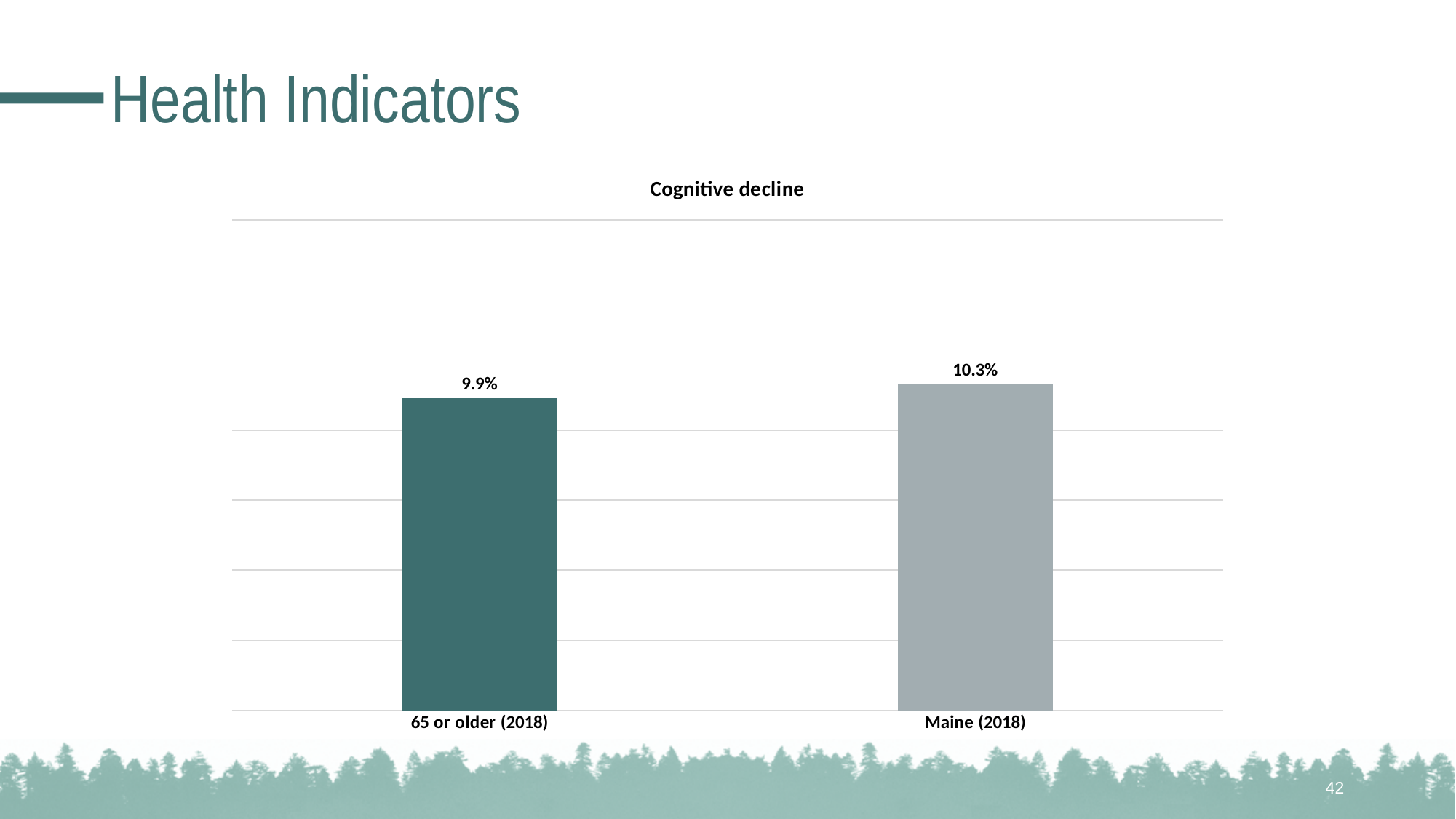
Which is larger: the value for 65 or older (2018) or the value for Maine (2018)? Maine (2018) What is the title of the chart on the slide? Cognitive decline Which category has the lowest value in the Cognitive decline chart? 65 or older (2018) What colour is the bar for 65 or older (2018)? Dark teal How many categories are shown in the Cognitive decline chart? 2 What kind of chart is shown on the slide? Bar chart What is the difference between the Maine (2018) value and the 65 or older (2018) value? 0.4% What is the value for 65 or older (2018) in the Cognitive decline chart? 9.9% Which category has the highest value in the Cognitive decline chart? Maine (2018) What is the value for Maine (2018) in the Cognitive decline chart? 10.3%